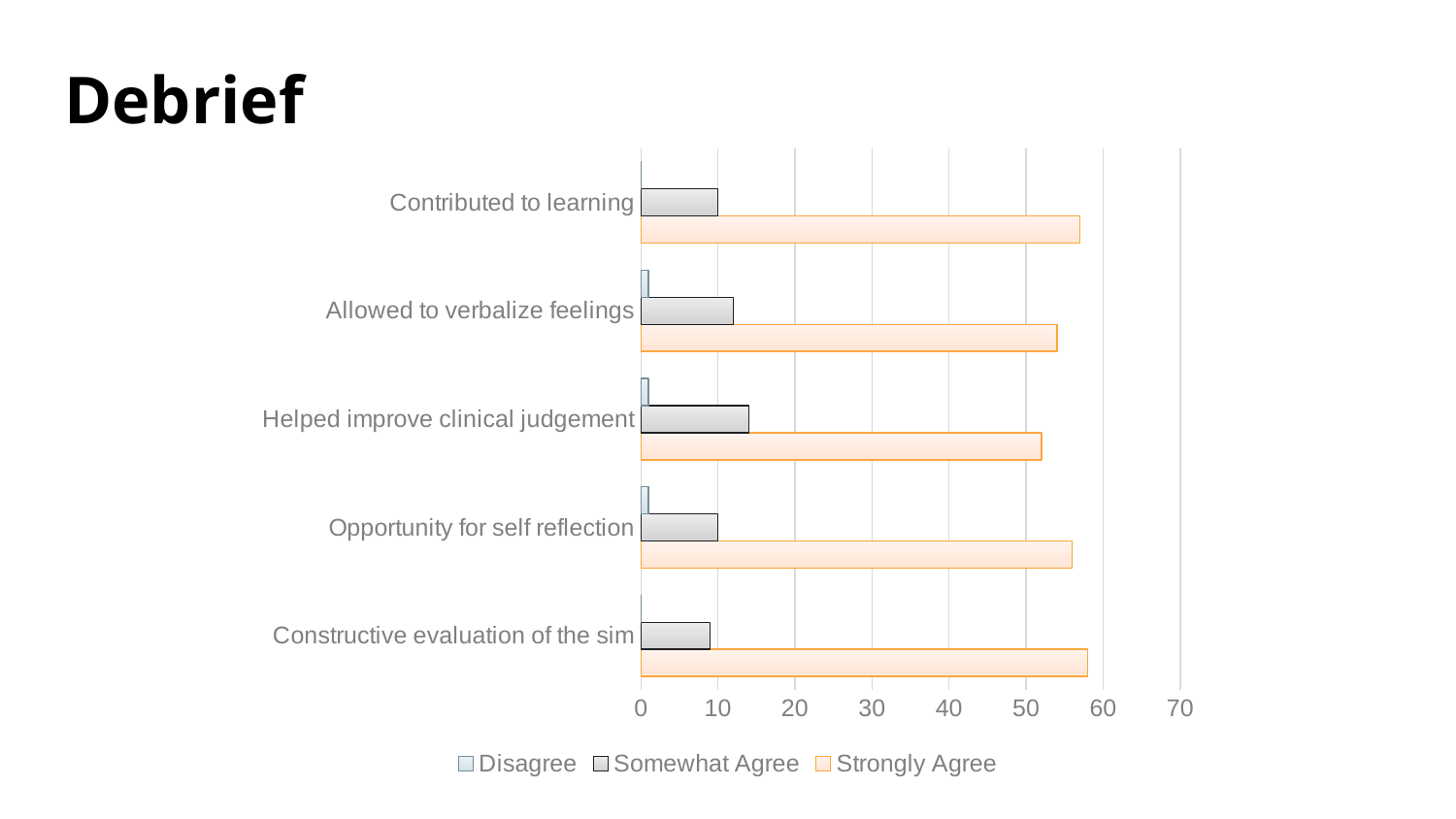
What is the title of the slide? Debrief Which is larger: the Somewhat Agree value for Helped improve clinical judgement or for Contributed to learning? Helped improve clinical judgement How many series does the legend list? 3 Is the Somewhat Agree value for Allowed to verbalize feelings greater or less than 10? greater What are the three series listed in the legend? Disagree, Somewhat Agree, Strongly Agree Is the Strongly Agree value for Constructive evaluation of the sim greater or less than 50? greater Is the Somewhat Agree value for Helped improve clinical judgement greater or less than 20? less How many categories are shown on the chart? 5 Which is larger: the Strongly Agree value for Contributed to learning or for Helped improve clinical judgement? Contributed to learning What kind of chart is shown on the slide? bar chart